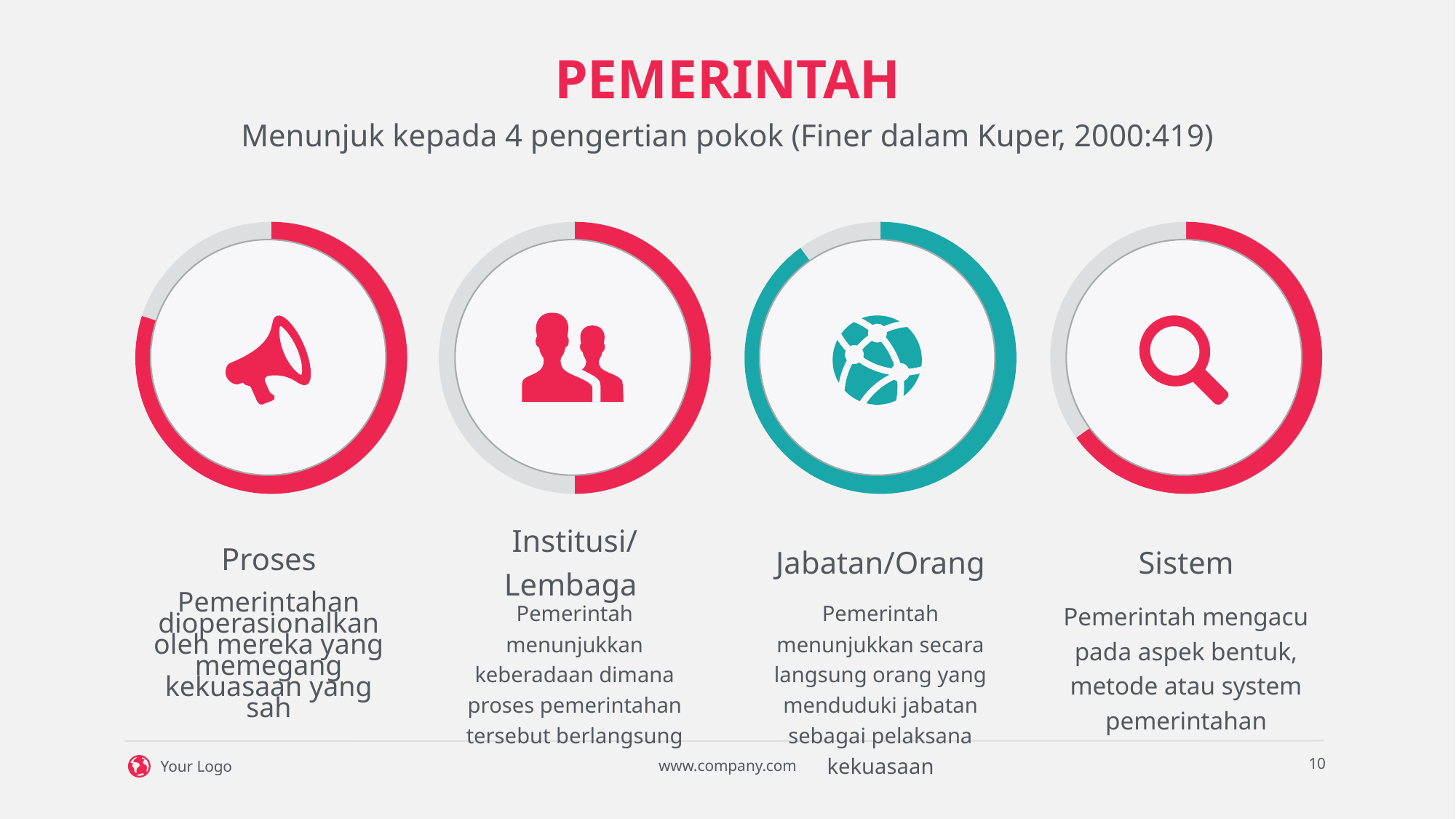
How many ring-shaped graphics are shown on the slide? 4 Which of the four rings has the largest filled portion? Jabatan/Orang Which ring graphic is filled in a different colour from the others? Jabatan/Orang What colour is the filled portion of the ring above Jabatan/Orang? Teal